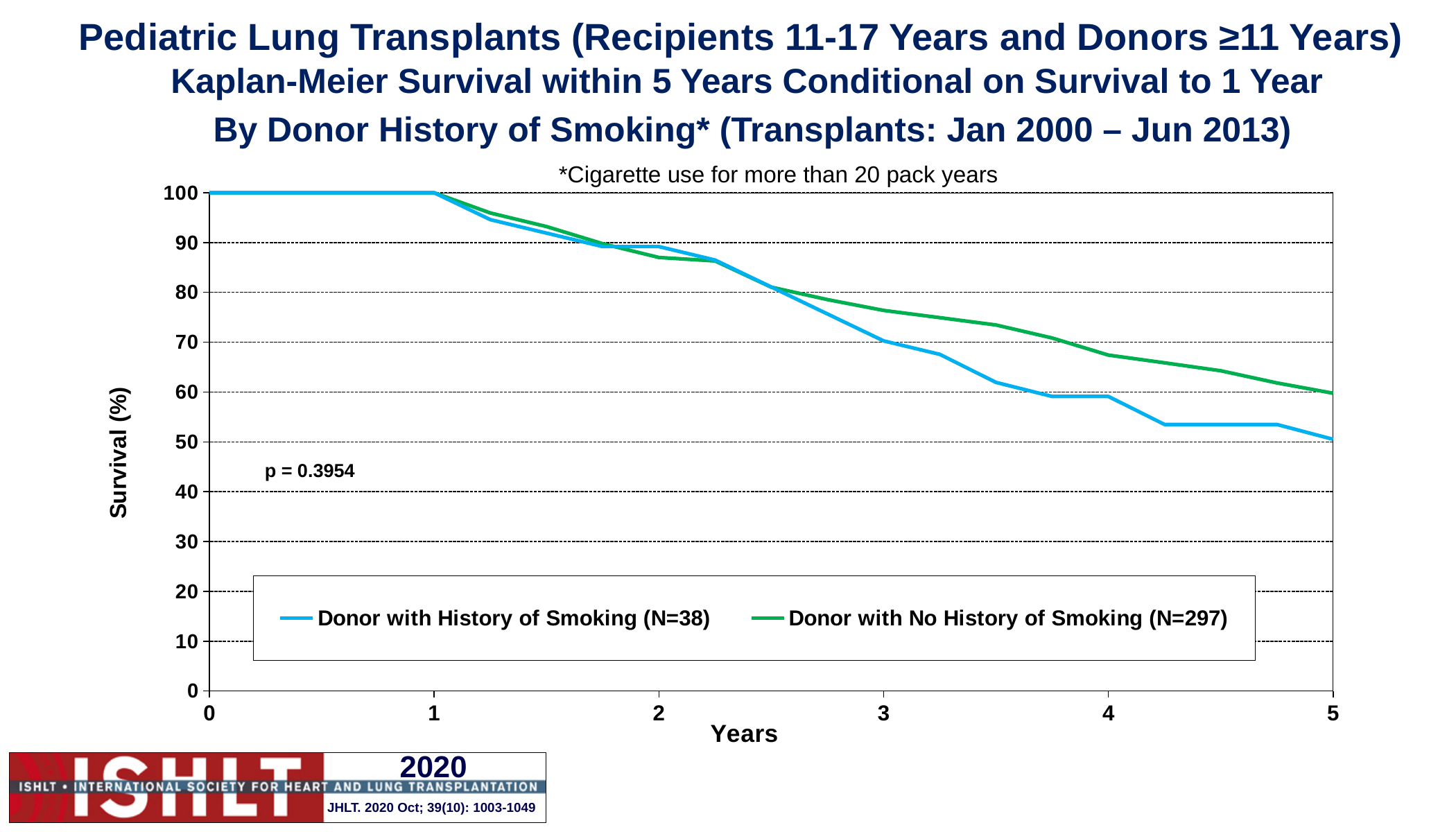
At year 5, which series has the higher survival: Donor with History of Smoking or Donor with No History of Smoking? Donor with No History of Smoking Is the survival value for Donor with History of Smoking at year 4 greater or less than 70? less Is the survival value for Donor with No History of Smoking at year 3 greater or less than 70? greater How many series does the legend list? 2 What is the survival value for Donor with No History of Smoking at year 1? 100 What p-value is shown on the chart? p = 0.3954 What is the sample size (N) for the Donor with History of Smoking series in the legend? N=38 What kind of chart is shown on the slide? Line chart What is the survival value for Donor with History of Smoking at year 0? 100 Do the survival curves rise or fall as years increase? Fall Is the survival value for Donor with No History of Smoking at year 2 greater or less than 80? greater At year 4, which series has the higher survival: Donor with History of Smoking or Donor with No History of Smoking? Donor with No History of Smoking